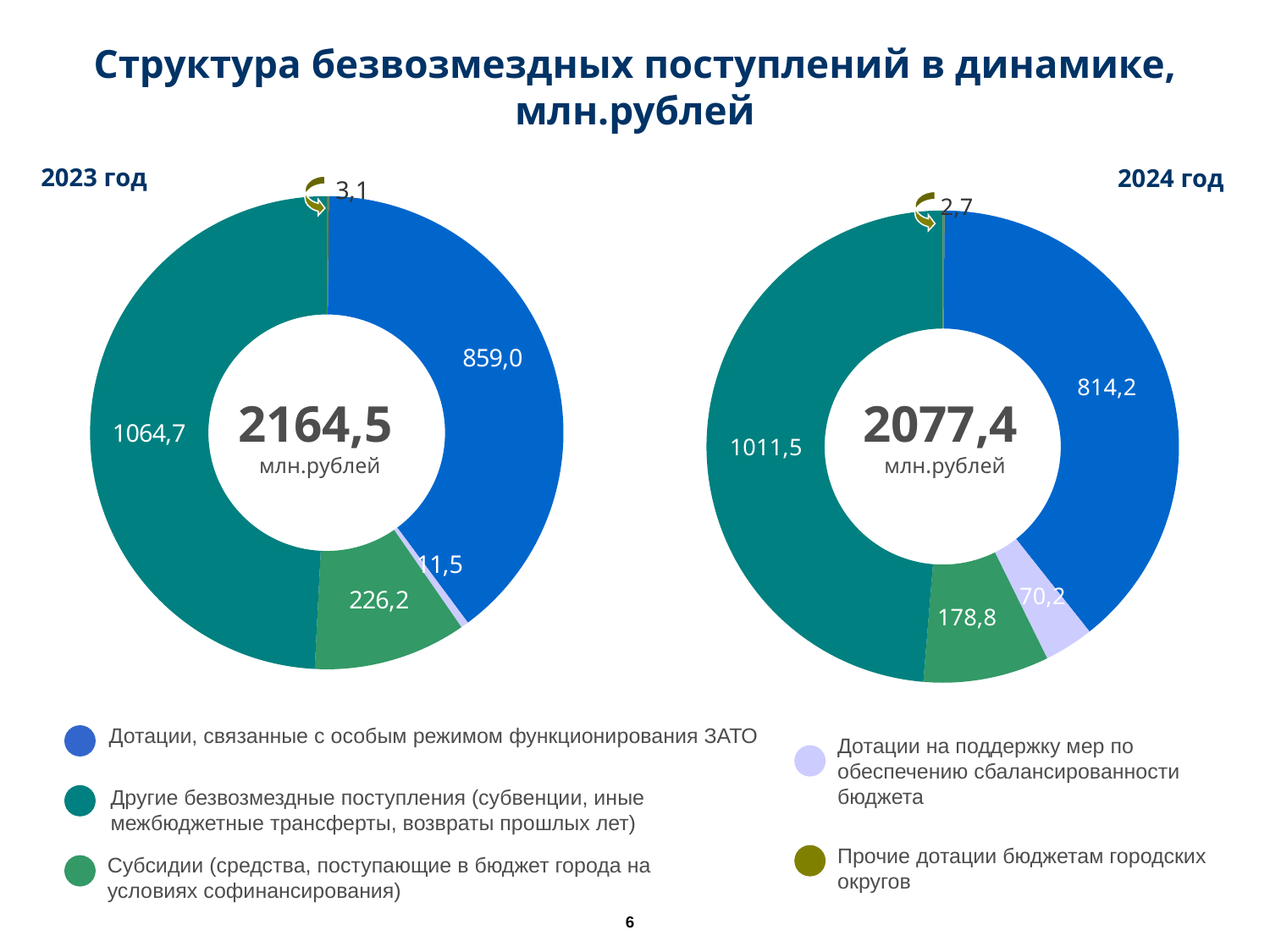
What colour represents Другие безвозмездные поступления in the charts? Teal (dark green) In the 2024 год chart, what is the value for Субсидии (средства, поступающие в бюджет города на условиях софинансирования)? 178,8 In the 2024 год chart, which category has the smallest value? Прочие дотации бюджетам городских округов What is the difference between the value for Дотации, связанные с особым режимом функционирования ЗАТО in the 2023 год chart and in the 2024 год chart? 44,8 In the 2023 год chart, what is the value for Дотации, связанные с особым режимом функционирования ЗАТО? 859,0 How many slices does the 2023 год chart have? 5 Which is larger: the value for Субсидии in the 2023 год chart or in the 2024 год chart? 2023 год What is the total shown in the centre of the 2024 год chart? 2077,4 млн.рублей What type of chart is used for the 2023 год and 2024 год data? Donut (pie) chart In the 2023 год chart, what is the value for Прочие дотации бюджетам городских округов? 3,1 In the 2023 год chart, which category has the largest value? Другие безвозмездные поступления (субвенции, иные межбюджетные трансферты, возвраты прошлых лет) In the 2024 год chart, what is the value for Дотации на поддержку мер по обеспечению сбалансированности бюджета? 70,2